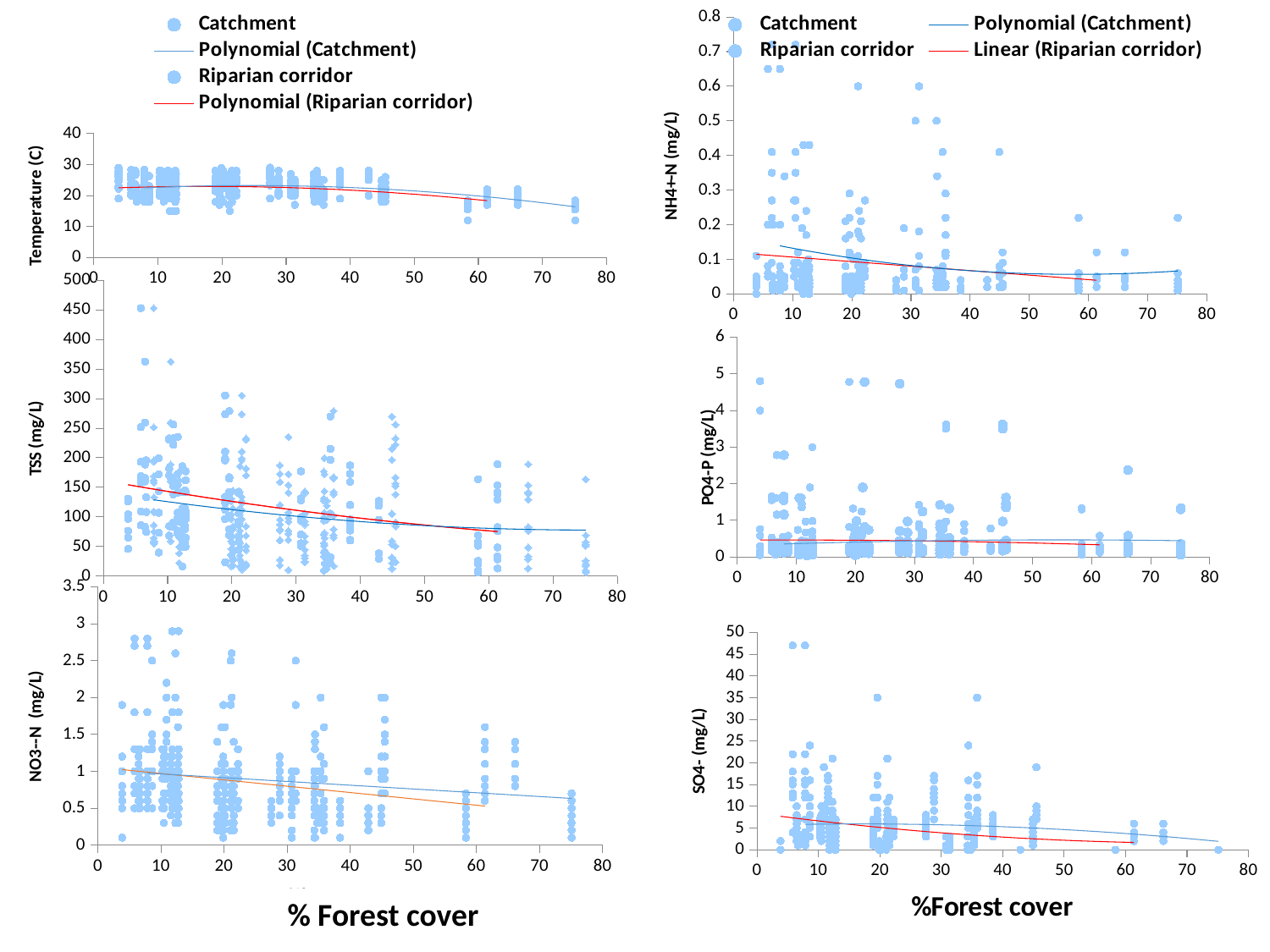
How many charts are shown on the slide? 6 What kind of chart is the Temperature (C) chart on the slide? Scatter chart In the legend above the NH4+-N (mg/L) chart, what type of trend line is listed for Riparian corridor? Linear (Riparian corridor) How many entries does the legend above the Temperature (C) chart list? 4 In the NH4+-N (mg/L) chart, do the fitted trend lines rise or fall as % Forest cover increases? Fall What is the x-axis label shared by the charts on the slide? % Forest cover In the TSS (mg/L) chart, do the fitted trend lines rise or fall as % Forest cover increases? Fall In the NO3--N (mg/L) chart, do the fitted trend lines rise or fall as % Forest cover increases? Fall In the TSS (mg/L) chart, which fitted line is higher at 10% forest cover, Polynomial (Catchment) or Polynomial (Riparian corridor)? Polynomial (Riparian corridor) What kind of chart is the PO4-P (mg/L) chart on the slide? Scatter chart